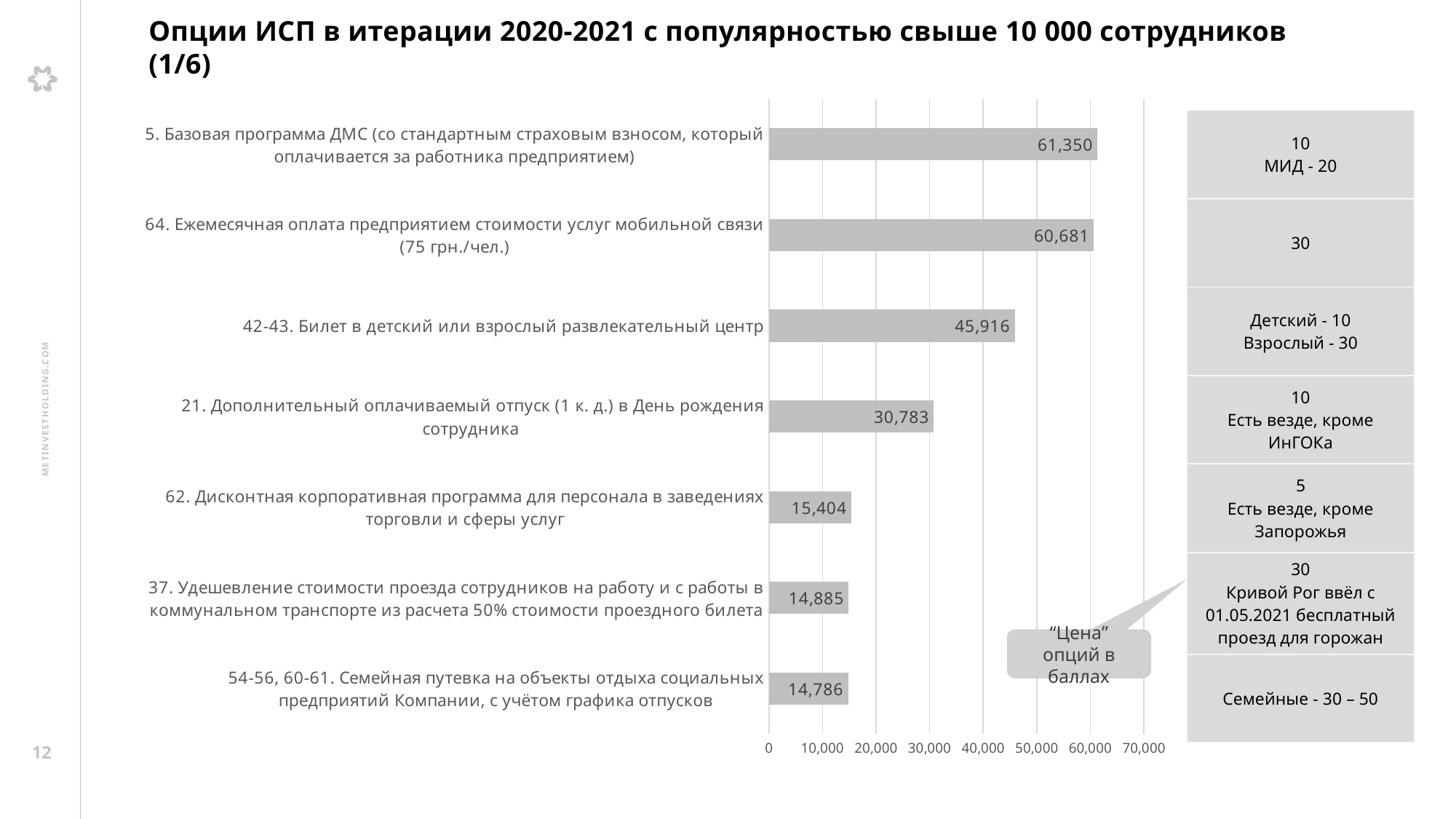
What is the value for option 54-56, 60-61 (Семейная путевка)? 14,786 What is the difference between the values for option 5 (Базовая программа ДМС) and option 64 (мобильная связь)? 669 What is the value for option 42-43 (Билет в детский или взрослый развлекательный центр)? 45,916 What is the value for option 21 (Дополнительный оплачиваемый отпуск в День рождения сотрудника)? 30,783 Which is larger: the value for option 62 (Дисконтная корпоративная программа) or option 37 (Удешевление стоимости проезда)? 62. Дисконтная корпоративная программа What is the highest tick value shown on the horizontal axis? 70,000 What is the value for option 64 (Ежемесячная оплата предприятием стоимости услуг мобильной связи)? 60,681 What is the value for option 5 (Базовая программа ДМС)? 61,350 Which option has the highest value? 5. Базовая программа ДМС Which option has the lowest value? 54-56, 60-61. Семейная путевка What type of chart is shown on the slide? Bar chart How many options (bars) are shown in the chart? 7